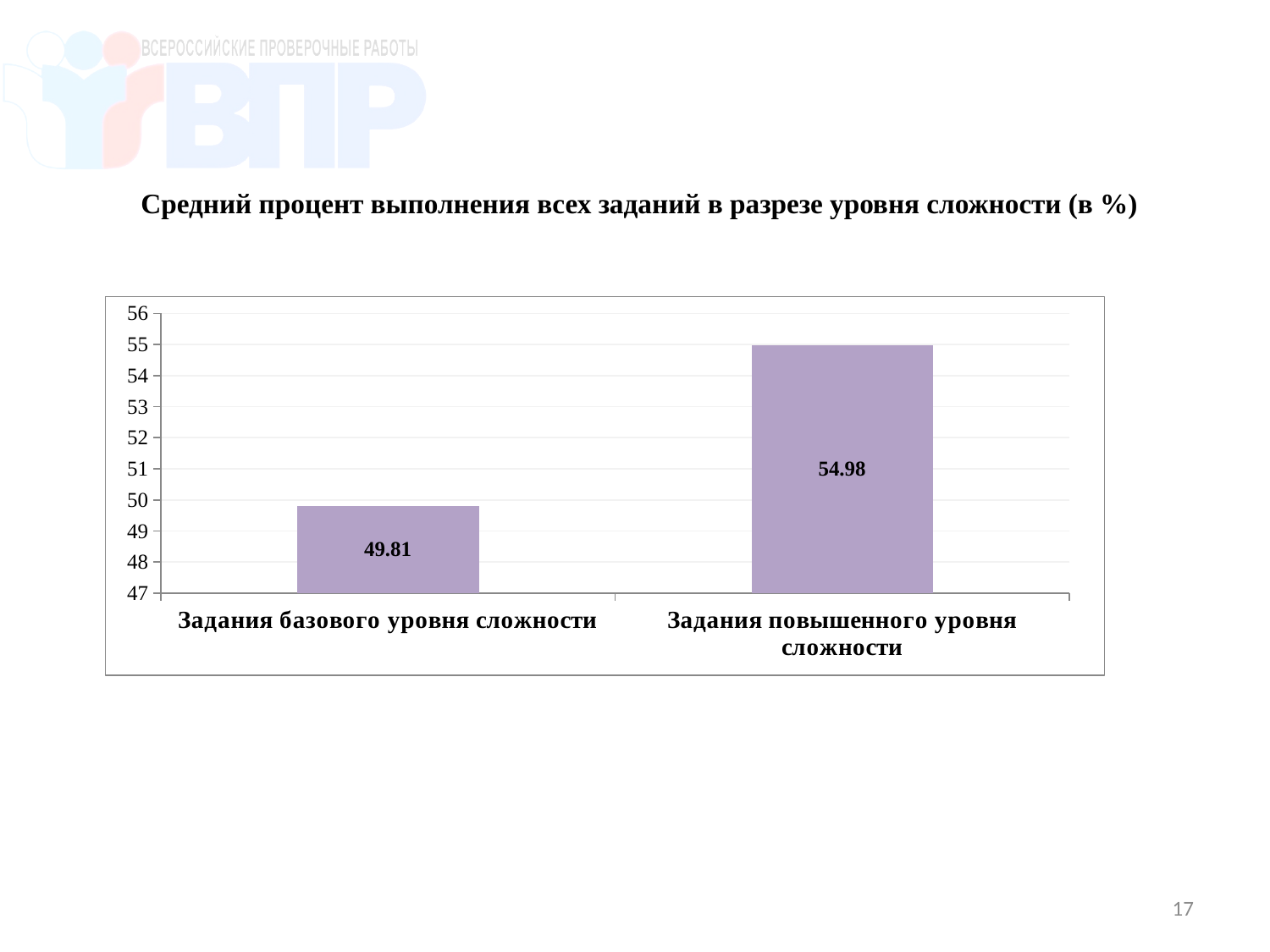
Which is larger: the value for Задания базового уровня сложности or the value for Задания повышенного уровня сложности? Задания повышенного уровня сложности Is the value for Задания базового уровня сложности greater or less than 50? less What kind of chart is shown on the slide? bar chart What is the lowest value shown on the vertical axis? 47 Which category has the lowest value? Задания базового уровня сложности What is the difference between the values for Задания повышенного уровня сложности and Задания базового уровня сложности? 5.17 Which category has the highest value? Задания повышенного уровня сложности What is the value for Задания базового уровня сложности? 49.81 What is the value for Задания повышенного уровня сложности? 54.98 What is the title of the chart? Средний процент выполнения всех заданий в разрезе уровня сложности (в %) How many categories are shown in the chart? 2 Is the value for Задания повышенного уровня сложности greater or less than 54? greater